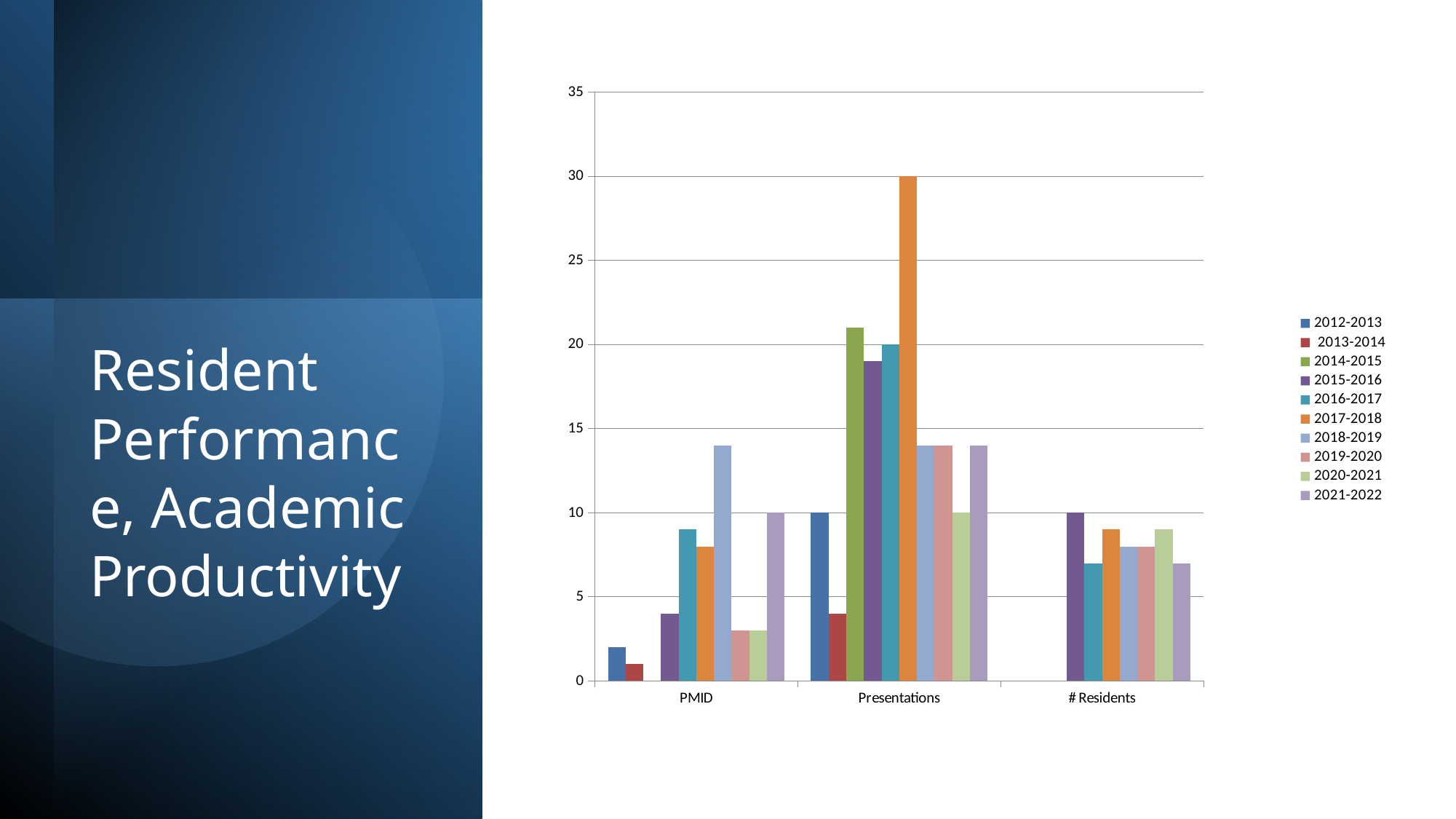
What is the value for 2017-2018 in the Presentations category? 30 What is the value for 2016-2017 in the Presentations category? 20 How many series does the legend list? 10 What is the value for 2012-2013 in the Presentations category? 10 What kind of chart is shown on the slide? bar chart What is the value for 2015-2016 in the # Residents category? 10 Which series has the highest value in the Presentations category? 2017-2018 How many categories are shown on the x axis? 3 Is the value for 2018-2019 in the PMID category greater or less than 10? greater Is the value for 2013-2014 in the Presentations category greater or less than 5? less Which is larger in the Presentations category: 2014-2015 or 2015-2016? 2014-2015 Which series has the highest value in the PMID category? 2018-2019